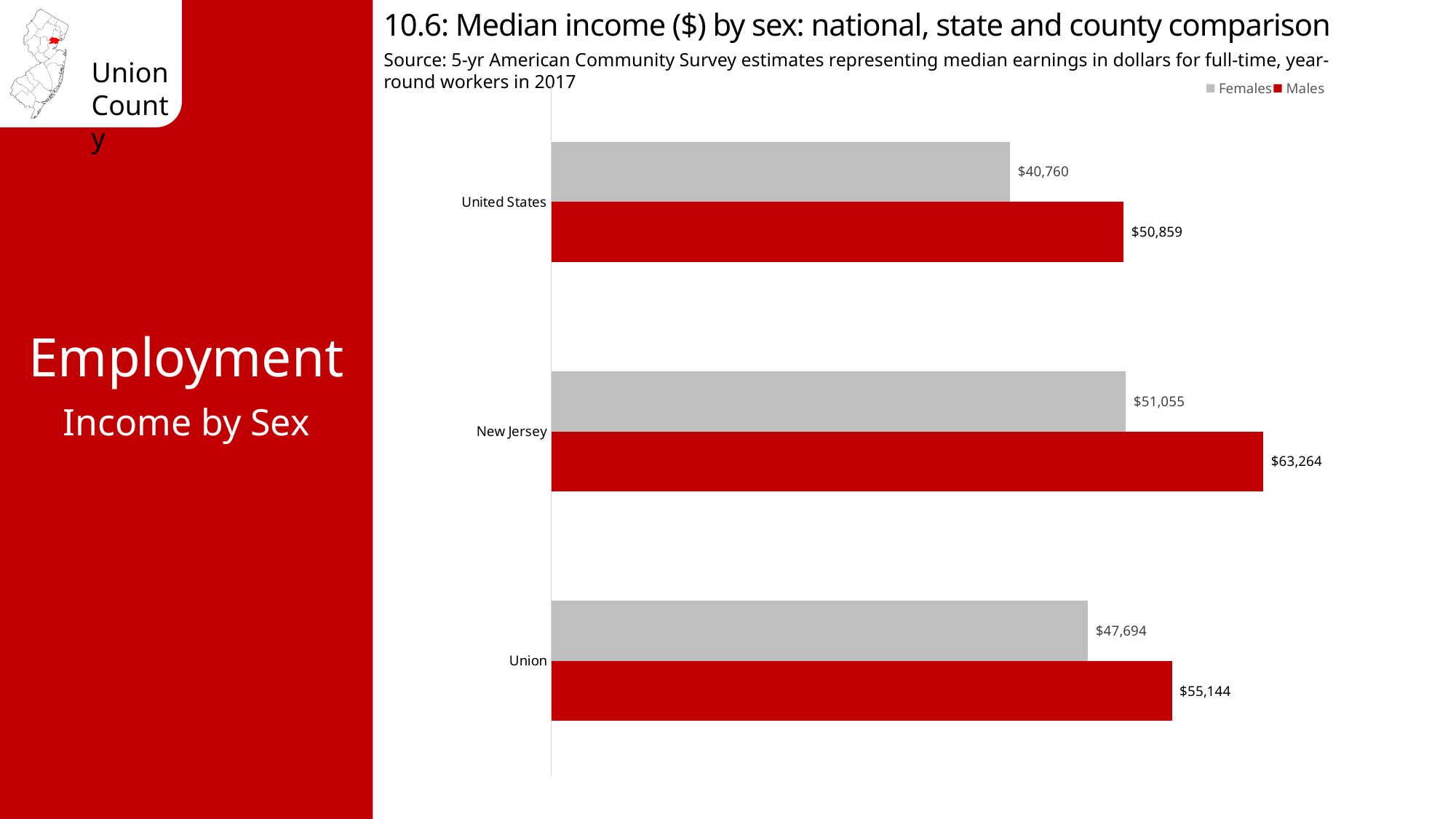
How many geographic categories are shown in the chart? 3 Which category has the highest median income for males? New Jersey What is the median income for females in the United States? $40,760 What is the median income for males in New Jersey? $63,264 What is the median income for males in Union? $55,144 What type of chart is shown on the slide? Bar chart What is the median income for females in Union? $47,694 Which category has the lowest median income for females? United States What is the difference between male and female median income in Union? $7,450 What is the difference between male and female median income in New Jersey? $12,209 How many series does the legend list? 2 Which is larger: the female median income in New Jersey or the male median income in the United States? Female median income in New Jersey